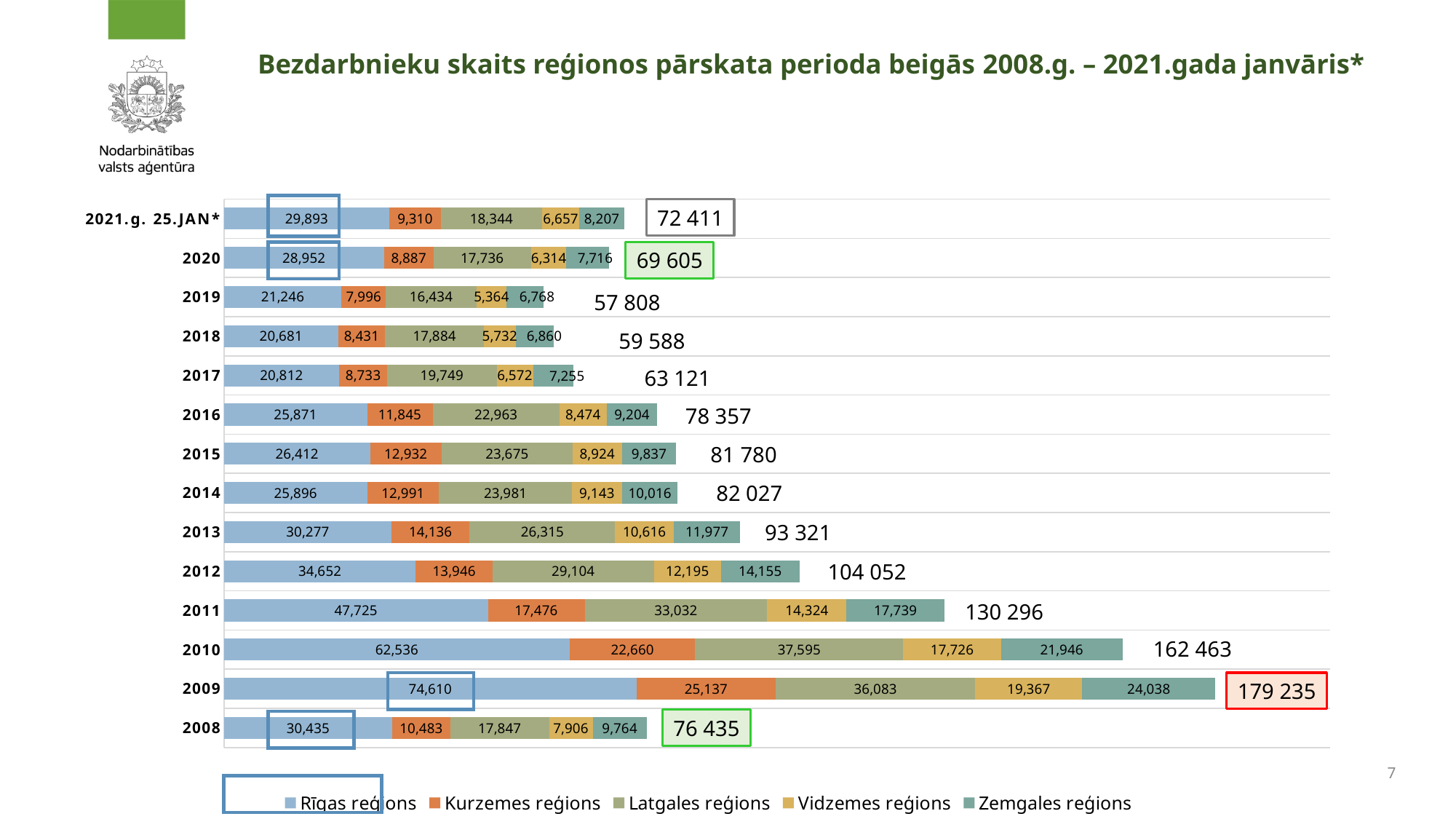
What is the value for Zemgales reģions in 2013? 11,977 What is the total of the stacked bar for 2012? 104 052 What is the difference between the Kurzemes reģions value for 2011 and for 2012? 3,530 What kind of chart is shown on the slide? Stacked bar chart Which is larger, the Latgales reģions value for 2010 or for 2009? 2010 Which year has the lowest total number of unemployed? 2019 What is the value for Rīgas reģions in 2009? 74,610 What is the difference between the Rīgas reģions value for 2021.g. 25.JAN* and for 2020? 941 How many years (categories) are shown on the chart? 14 What is the value for Vidzemes reģions in 2016? 8,474 Which year has the highest total number of unemployed? 2009 How many series does the legend list? 5